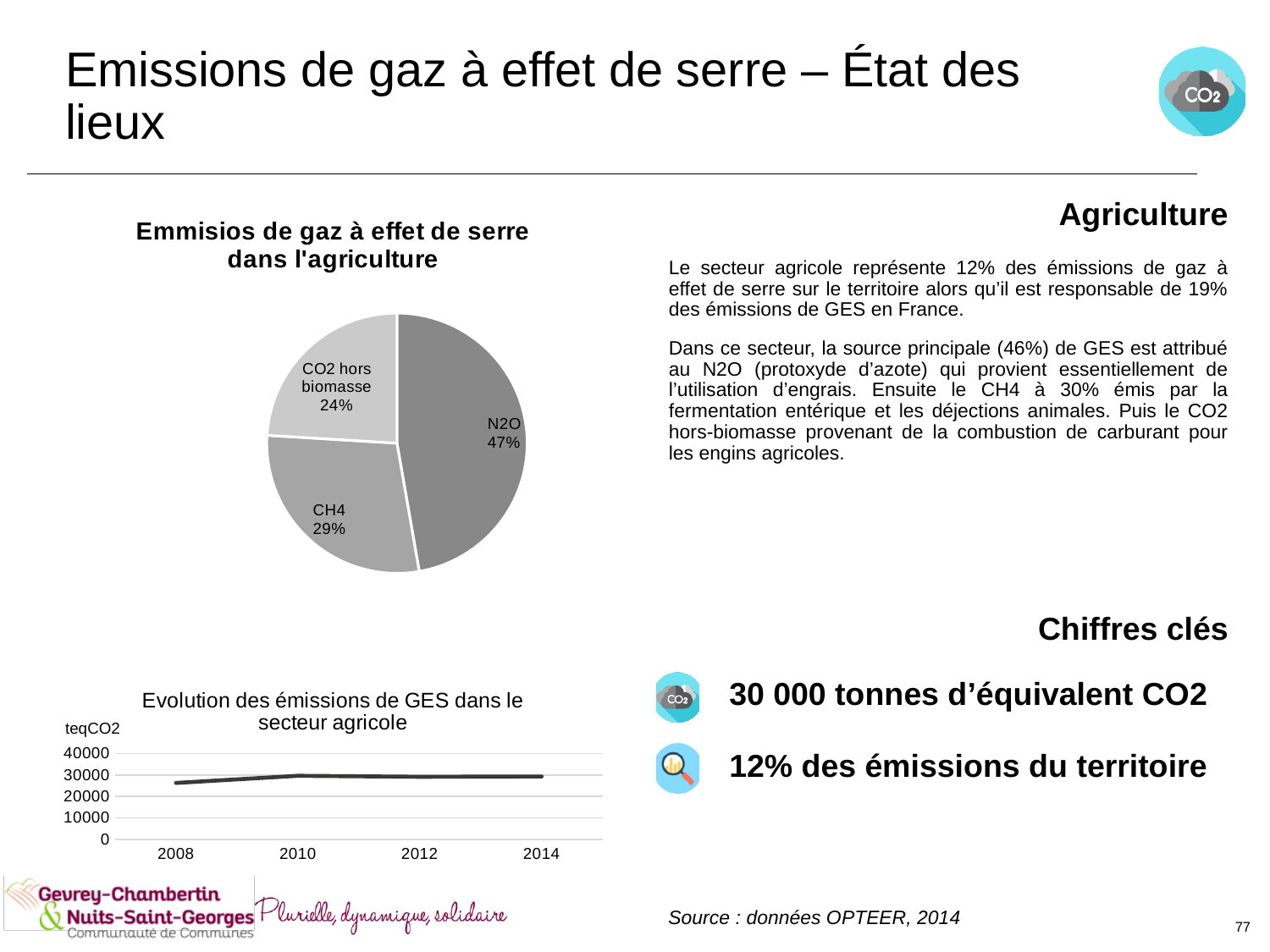
In the pie chart 'Emmisios de gaz à effet de serre dans l'agriculture', which is larger, the share of CH4 or the share of CO2 hors biomasse? CH4 In the pie chart 'Emmisios de gaz à effet de serre dans l'agriculture', which gas has the smallest share? CO2 hors biomasse What kind of chart is 'Evolution des émissions de GES dans le secteur agricole'? Line chart In the pie chart 'Emmisios de gaz à effet de serre dans l'agriculture', which gas has the largest share? N2O What kind of chart is the top-left chart on the slide? Pie chart In the chart 'Evolution des émissions de GES dans le secteur agricole', is the value for 2008 greater or less than 30000? less In the pie chart 'Emmisios de gaz à effet de serre dans l'agriculture', how many slices are there? 3 In the pie chart 'Emmisios de gaz à effet de serre dans l'agriculture', what share is attributed to CO2 hors biomasse? 24% In the pie chart 'Emmisios de gaz à effet de serre dans l'agriculture', what share is attributed to N2O? 47% In the pie chart 'Emmisios de gaz à effet de serre dans l'agriculture', by how many percentage points does N2O exceed CH4? 18 percentage points In the chart 'Evolution des émissions de GES dans le secteur agricole', what unit is shown on the vertical axis? teqCO2 In the pie chart 'Emmisios de gaz à effet de serre dans l'agriculture', what share is attributed to CH4? 29%